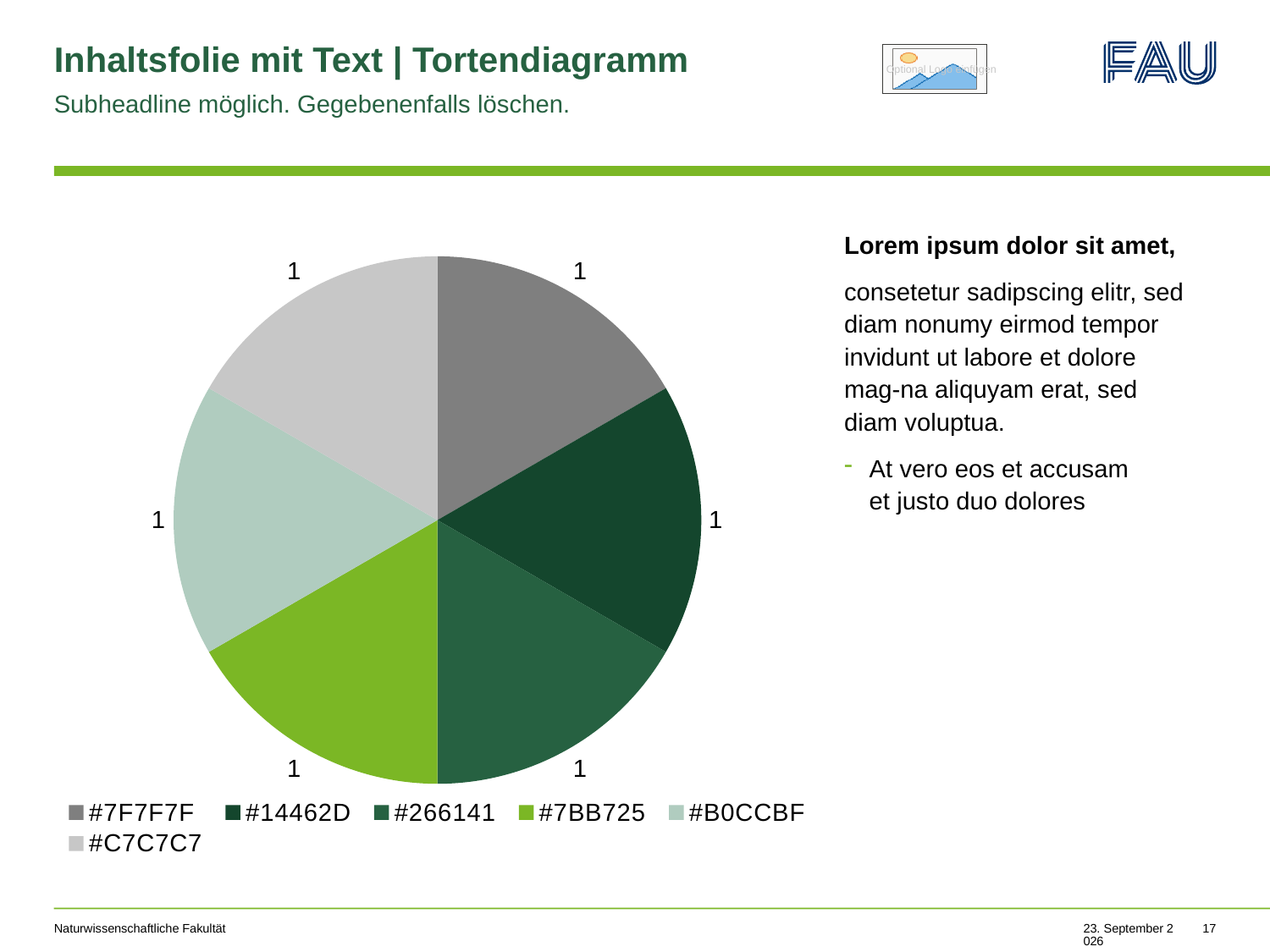
What share of the pie does the #7F7F7F slice represent? 1/6 What is the total of all slice values in the pie chart? 6 What is the value of the slice labelled #7BB725 in the pie chart? 1 Which legend entry is listed last in the pie chart's legend? #C7C7C7 Which legend entry is listed first in the pie chart's legend? #7F7F7F What is the value of the slice labelled #7F7F7F in the pie chart? 1 How many entries does the legend of the pie chart list? 6 What is the difference between the values of the #266141 and #B0CCBF slices in the pie chart? 0 What is the value of the slice labelled #C7C7C7 in the pie chart? 1 How many slices does the pie chart have? 6 What kind of chart is shown on the slide? pie chart What is the value of the slice labelled #14462D in the pie chart? 1